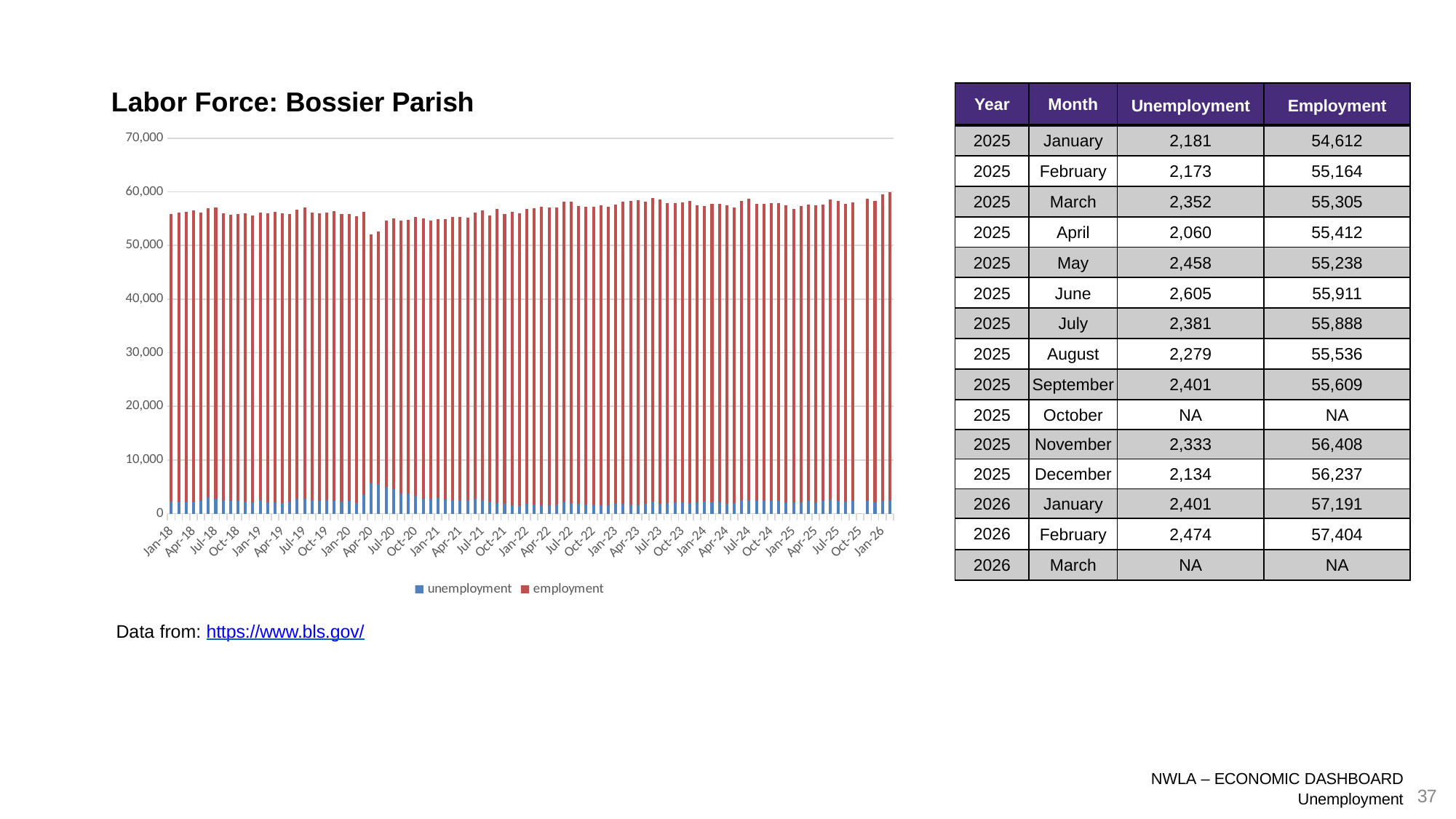
What kind of chart is shown on the slide? bar chart Is the employment value for Apr-20 greater or less than 60,000? less Is the employment value for Jan-18 greater or less than 50,000? greater Does employment generally rise or fall from Jan-21 to Jan-26? rise Is the unemployment value for Jan-18 greater or less than 10,000? less How many series does the chart legend list? 2 According to the table on the slide, what was employment in Bossier Parish in February 2026? 57,404 What are the two series named in the chart legend? unemployment and employment According to the table on the slide, which month listed has the highest unemployment? June 2025 Which is larger, the employment bar for Jan-26 or the employment bar for Apr-20? Jan-26 Using the table values, how much higher is employment in February 2026 than in January 2026? 213 What is the title of the chart? Labor Force: Bossier Parish